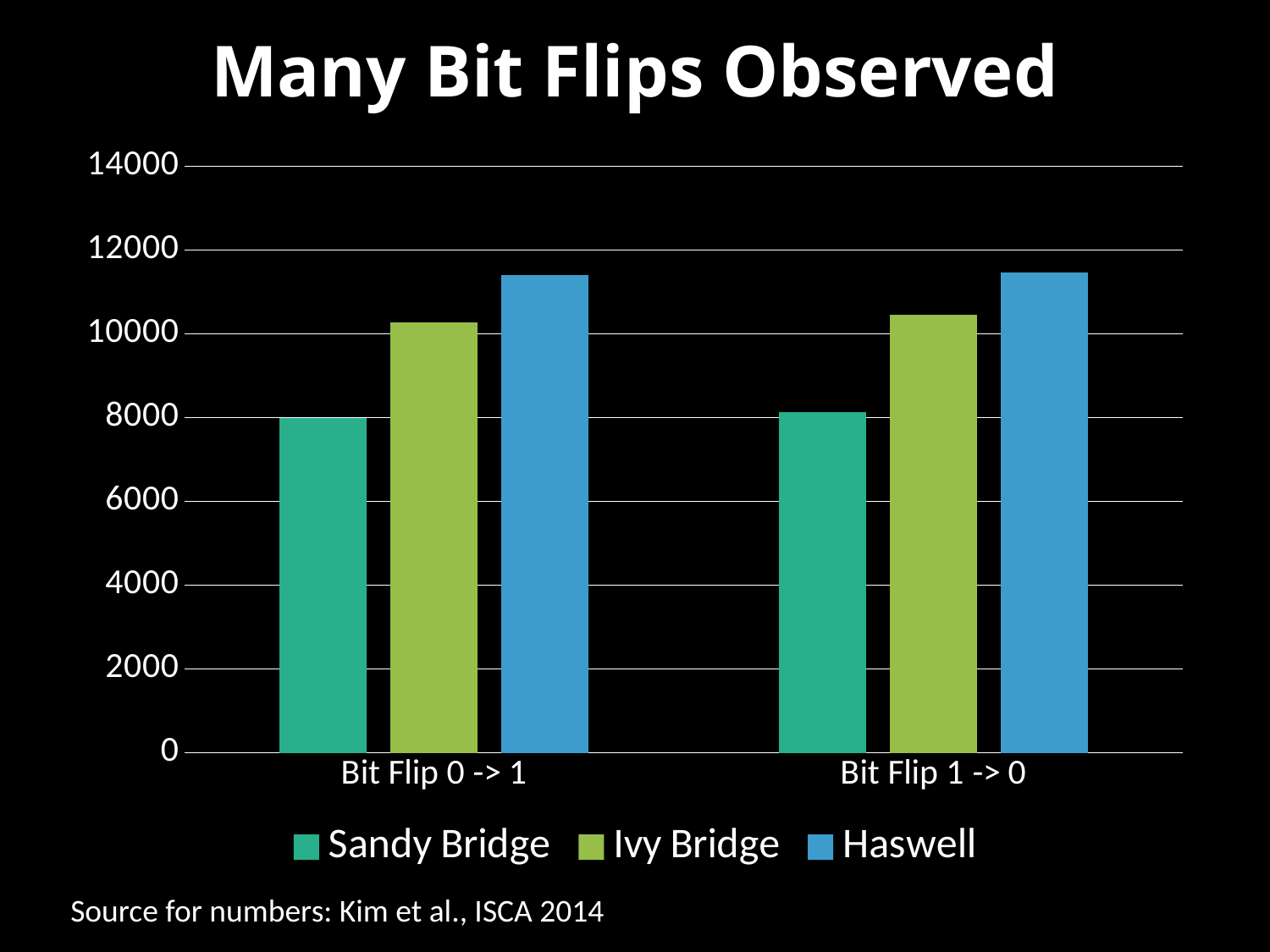
Is the value for Haswell in Bit Flip 0 -> 1 greater or less than 10000? greater Is the value for Sandy Bridge in Bit Flip 0 -> 1 greater or less than 10000? less Is the value for Sandy Bridge in Bit Flip 1 -> 0 greater or less than 6000? greater What is the title of the chart? Many Bit Flips Observed How many categories are shown on the x axis? 2 How many series does the legend list? 3 What kind of chart is shown on the slide? bar chart Which series is shown in blue in the legend? Haswell Which series has the lowest value for Bit Flip 1 -> 0? Sandy Bridge For Bit Flip 1 -> 0, which is larger: Ivy Bridge or Sandy Bridge? Ivy Bridge Which series has the highest value for Bit Flip 0 -> 1? Haswell